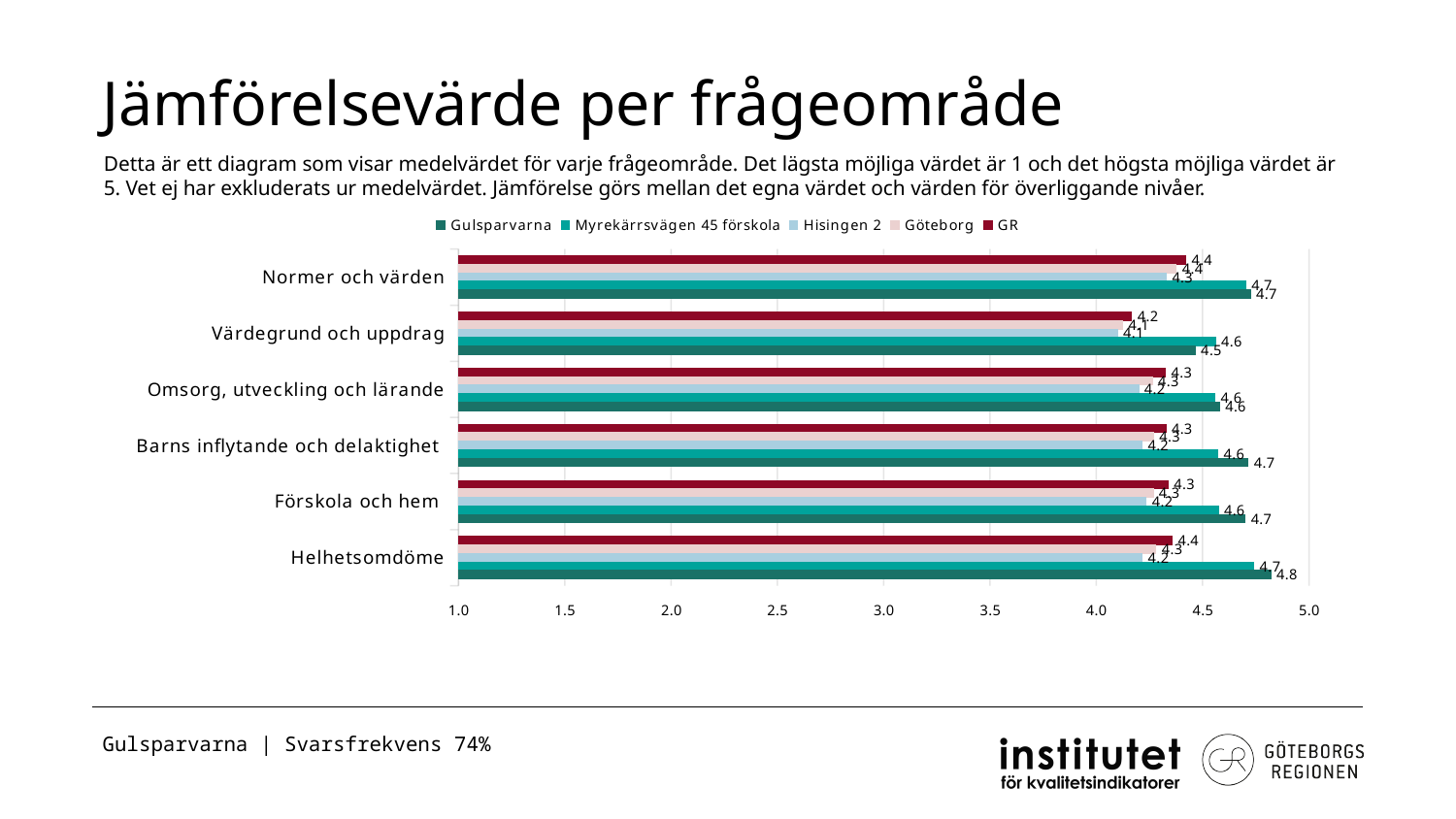
What kind of chart is shown on the slide? Bar chart What is the value for Gulsparvarna in the Helhetsomdöme category? 4.8 In which category does Gulsparvarna have its highest value? Helhetsomdöme In which category does Gulsparvarna have its lowest value? Värdegrund och uppdrag What is the value for Myrekärrsvägen 45 förskola in the Normer och värden category? 4.7 How many series does the legend list? 5 How many categories (question areas) are shown on the chart? 6 What is the value for GR in the Värdegrund och uppdrag category? 4.2 Is the value for GR in the Normer och värden category greater or less than 4.0? greater What is the difference between the Gulsparvarna values for Helhetsomdöme and Värdegrund och uppdrag? 0.3 What is the value for Gulsparvarna in the Värdegrund och uppdrag category? 4.5 In the Värdegrund och uppdrag category, which is larger: the value for Gulsparvarna or the value for GR? Gulsparvarna